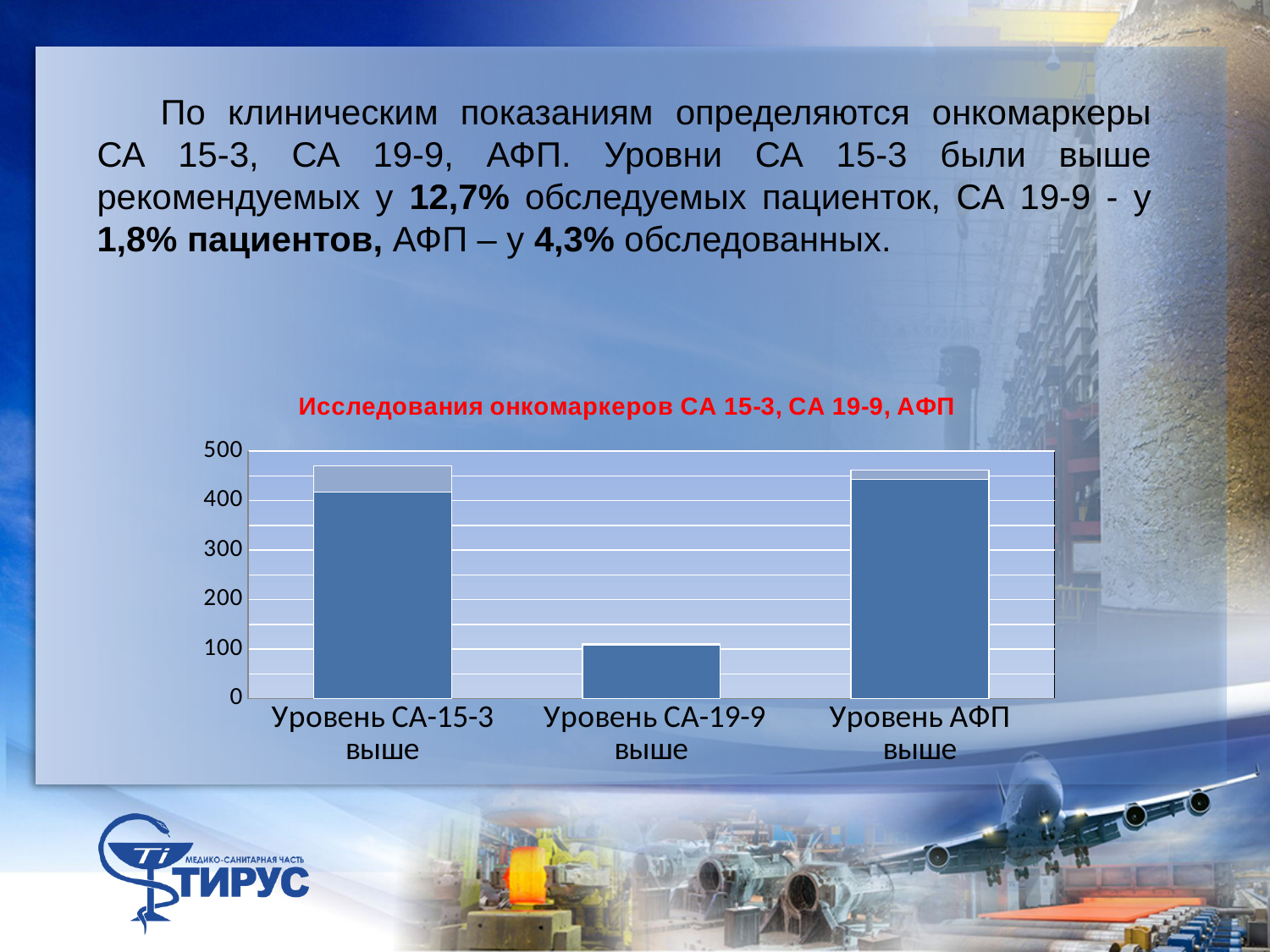
Is the value for Уровень АФП выше greater or less than 400? greater Which category has the lowest bar in the chart? Уровень СА-19-9 выше Which bar is taller: Уровень СА-15-3 выше or Уровень СА-19-9 выше? Уровень СА-15-3 выше What kind of chart is shown on the slide? bar chart Is the total height of the bar for Уровень СА-15-3 выше greater or less than 400? greater Is the value for Уровень СА-19-9 выше greater or less than 300? less How many categories are shown on the x axis of the chart? 3 Which bar is taller: Уровень СА-19-9 выше or Уровень АФП выше? Уровень АФП выше What is the title of the chart? Исследования онкомаркеров СА 15-3, СА 19-9, АФП What is the highest value shown on the y axis of the chart? 500